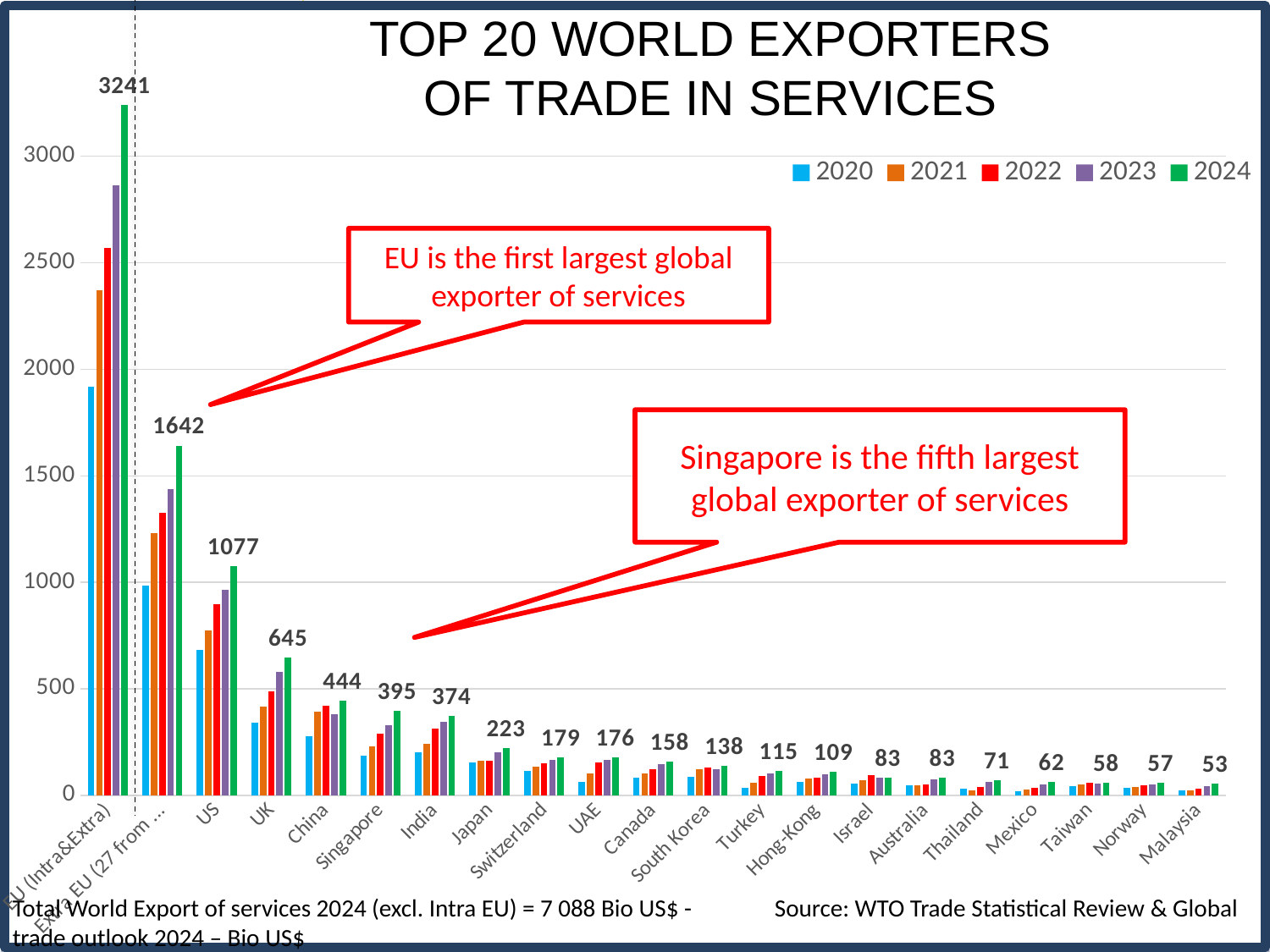
Is the 2023 value for EU (Intra&Extra) greater or less than 2500? greater What is the 2024 value for Japan? 223 What is the 2024 value for the US? 1077 Is the 2020 value for the US greater or less than 1000? less What kind of chart is shown on the slide? Bar chart Which has the larger 2024 value, China or India? China How many series does the legend list? 5 Do the values for EU (Intra&Extra) rise or fall from 2020 to 2024? Rise Which category has the highest 2024 value? EU (Intra&Extra) What is the 2024 value for Singapore? 395 What is the difference between the 2024 values for the US and the UK? 432 Which category has the lowest 2024 value? Malaysia